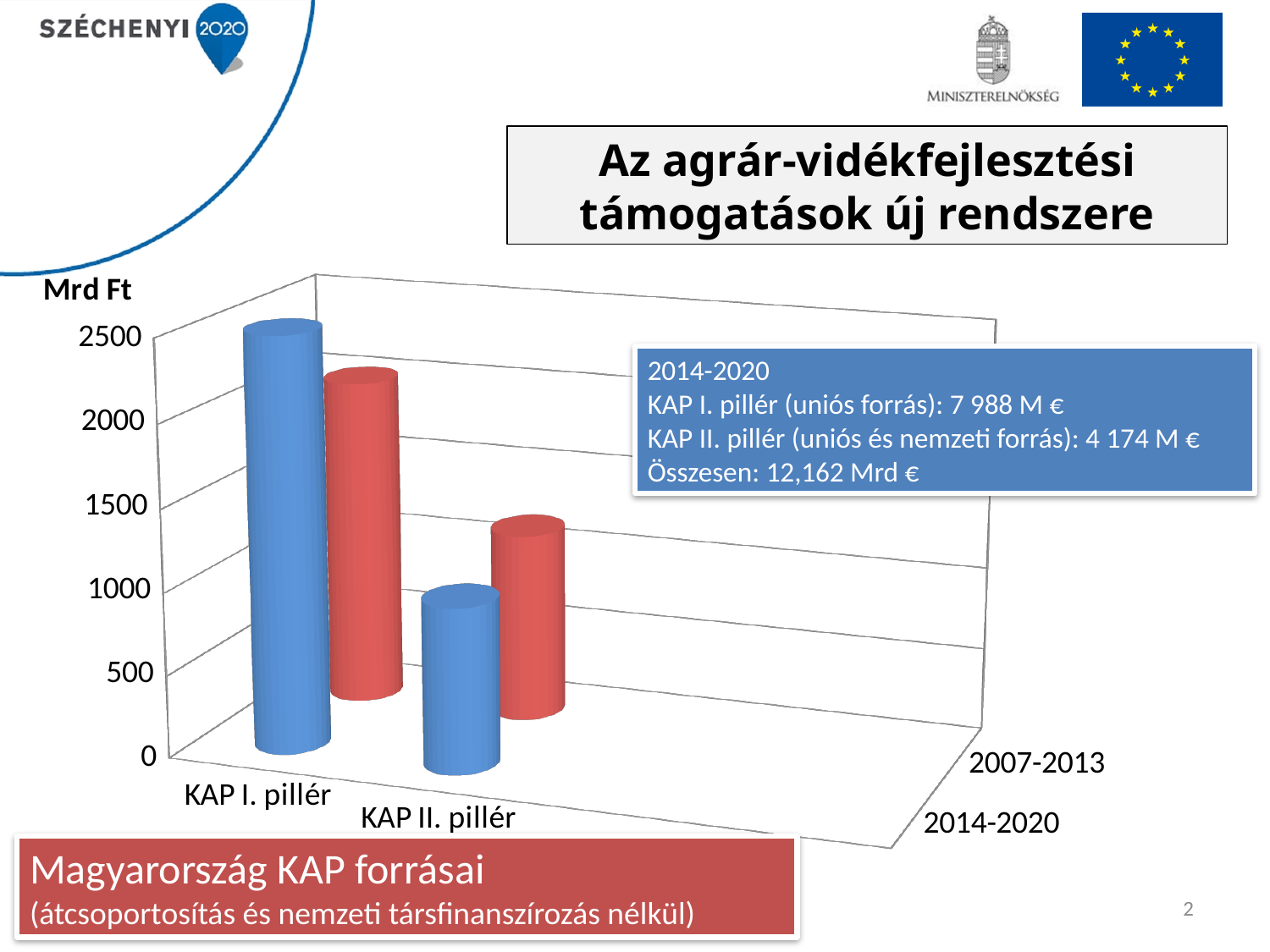
What unit is shown on the vertical axis of the chart? Mrd Ft Is the value for KAP I. pillér in 2014-2020 greater or less than 1500? greater What kind of chart is shown on the slide? bar chart For KAP I. pillér, which period has the larger value, 2007-2013 or 2014-2020? 2014-2020 Which category and period has the highest bar in the chart? KAP I. pillér, 2014-2020 For KAP II. pillér, which period has the larger value, 2007-2013 or 2014-2020? 2007-2013 Which category and period has the lowest bar in the chart? KAP II. pillér, 2014-2020 Is the value for KAP II. pillér in 2007-2013 greater or less than 1500? less How many series (periods) does the chart show? 2 How many categories are shown on the x axis of the chart? 2